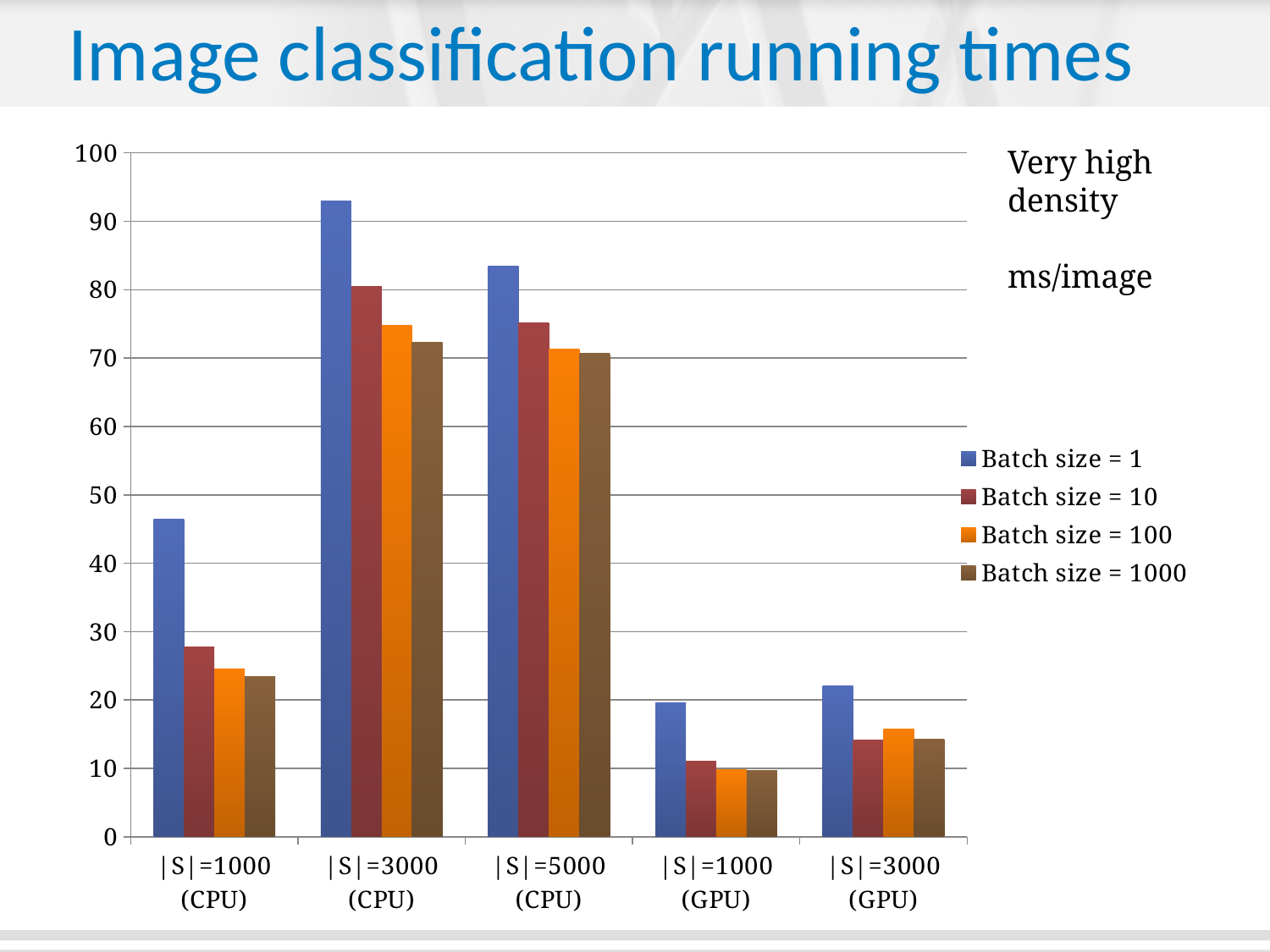
For the Batch size = 1 series, which is larger: |S|=3000 (CPU) or |S|=5000 (CPU)? |S|=3000 (CPU) What kind of chart is shown on the slide? bar chart How many series does the chart's legend list? 4 Within the |S|=1000 (CPU) category, which batch size series has the highest value? Batch size = 1 Is the Batch size = 1000 value for |S|=5000 (CPU) greater or less than 60? greater How many categories are shown along the x axis of the chart? 5 For the Batch size = 1 series, which category has the highest value? |S|=3000 (CPU) Is the Batch size = 1 value for |S|=3000 (CPU) greater or less than 90? greater What is the title of the slide containing the chart? Image classification running times For the Batch size = 1 series, which category has the lowest value? |S|=1000 (GPU) What unit is indicated for the values in the chart? ms/image Is the Batch size = 1 value for |S|=1000 (CPU) greater or less than 40? greater